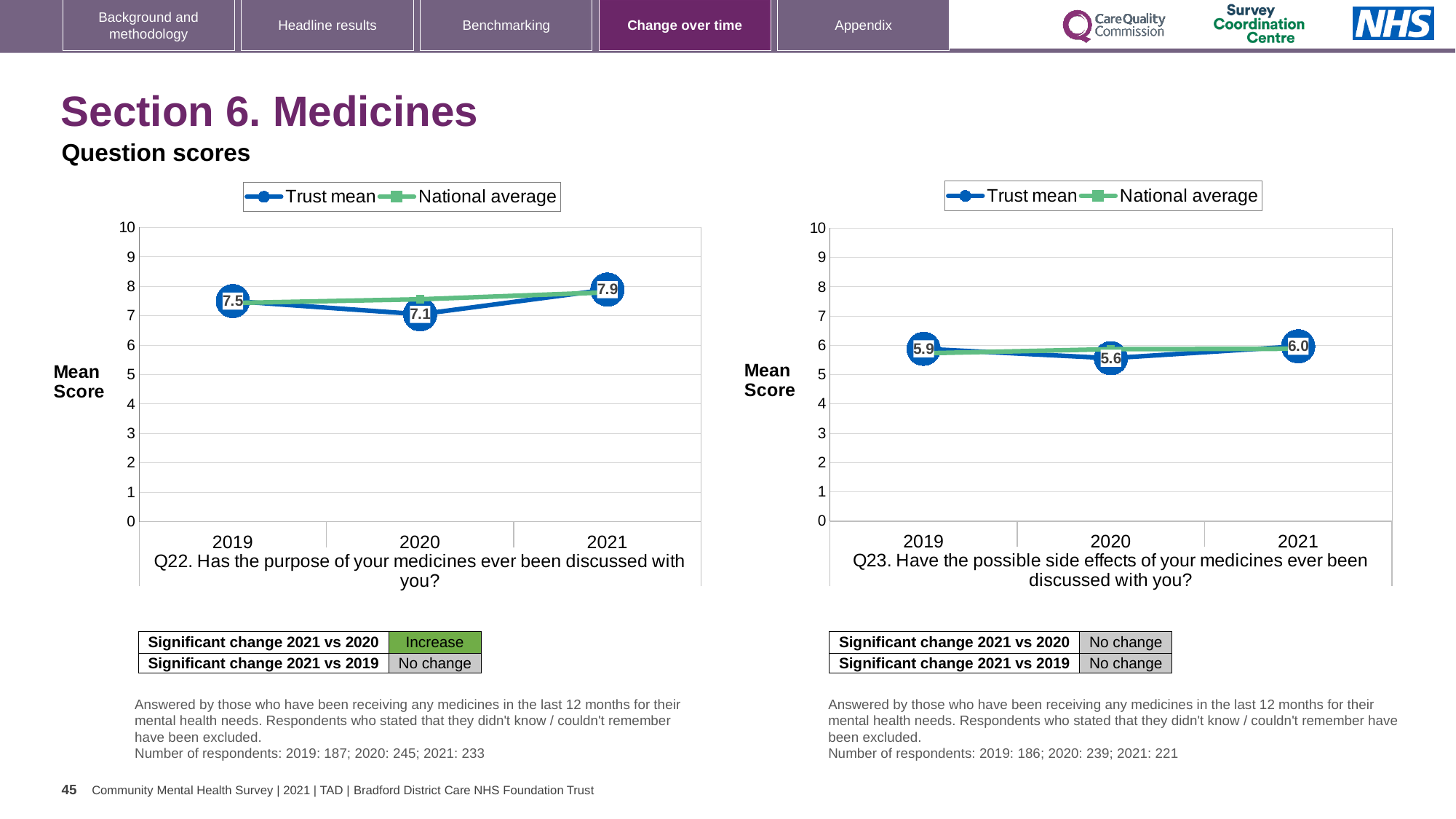
On the Q22 chart (left), is the Trust mean for 2021 larger or smaller than the Trust mean for 2019? larger How many series does the legend of the Q23 chart (right) list? 2 On the Q23 chart (right), is the Trust mean score for 2019 greater or less than 5? greater On the Q22 chart (left), what is the difference between the Trust mean scores for 2021 and 2020? 0.8 What kind of chart is the Q22 chart (left)? Line chart On the Q22 chart (left), what is the Trust mean score for 2020? 7.1 On the Q22 chart (left), which year has the highest Trust mean score? 2021 On the Q23 chart (right), what is the Trust mean score for 2021? 6.0 On the Q22 chart (left), what is the Trust mean score for 2019? 7.5 On the Q23 chart (right), which year has the lowest Trust mean score? 2020 On the Q23 chart (right), what is the Trust mean score for 2020? 5.6 On the Q22 chart (left), what is the Trust mean score for 2021? 7.9